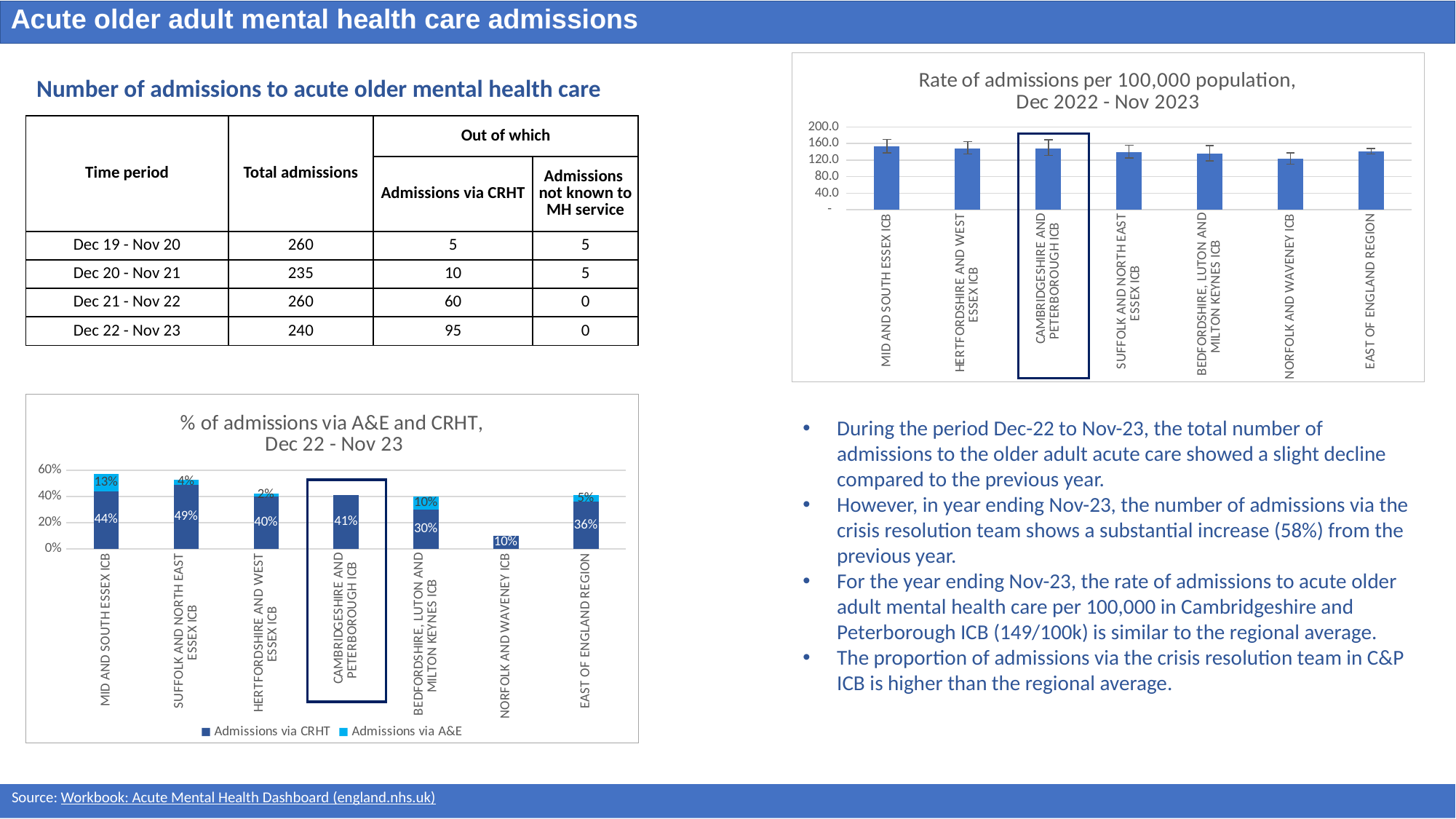
In the 'Rate of admissions per 100,000 population' chart, is the value for Norfolk and Waveney ICB greater or less than 160.0? less In the '% of admissions via A&E and CRHT' chart, what percentage of admissions in Bedfordshire, Luton and Milton Keynes ICB were via A&E? 10% How many series does the legend of the '% of admissions via A&E and CRHT' chart list? 2 In the '% of admissions via A&E and CRHT' chart, which is larger: the Admissions via A&E value for Mid and South Essex ICB or for East of England Region? Mid and South Essex ICB In the '% of admissions via A&E and CRHT' chart, what is the Admissions via CRHT value for Cambridgeshire and Peterborough ICB? 41% How many categories are shown on the x axis of the 'Rate of admissions per 100,000 population' chart? 7 In the 'Rate of admissions per 100,000 population' chart, which ICB has the lowest rate? Norfolk and Waveney ICB In the '% of admissions via A&E and CRHT' chart, what percentage of admissions in Mid and South Essex ICB were via CRHT? 44% In the '% of admissions via A&E and CRHT' chart, what is the difference between the Admissions via CRHT values for Suffolk and North East Essex ICB and East of England Region? 13% In the '% of admissions via A&E and CRHT' chart, which ICB has the lowest percentage of admissions via CRHT? Norfolk and Waveney ICB In the '% of admissions via A&E and CRHT' chart, what is the combined total of Admissions via CRHT and Admissions via A&E for Mid and South Essex ICB? 57% In the '% of admissions via A&E and CRHT' chart, which ICB has the highest percentage of admissions via CRHT? Suffolk and North East Essex ICB